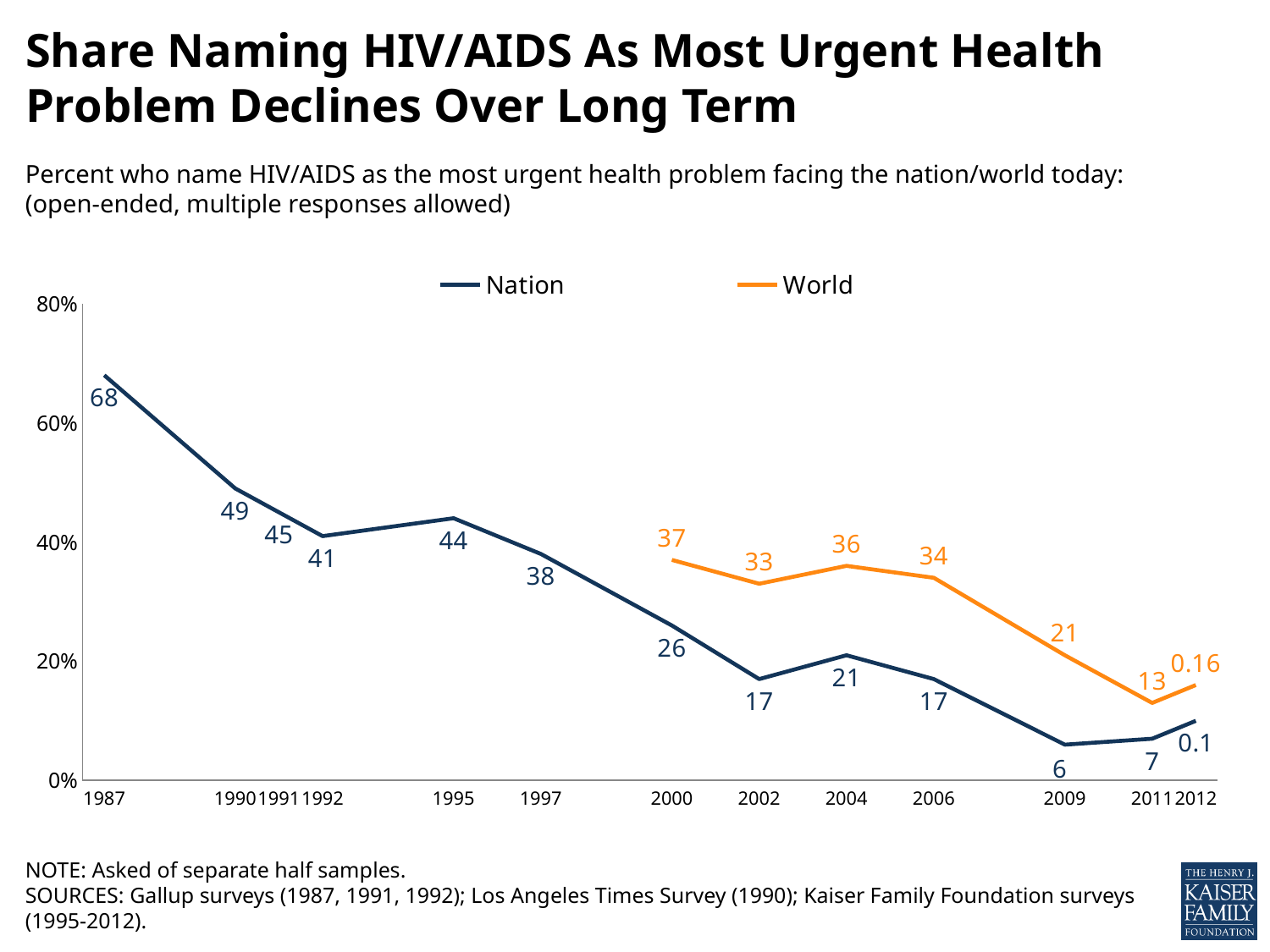
How many years are shown on the x axis? 13 How many series does the legend list? 2 In which year is the Nation series at its highest? 1987 What type of chart is shown on the slide? line chart What is the Nation value in 2009? 6 Which is larger in 2006, the Nation value or the World value? World Does the Nation series generally rise or fall from 1987 to 2009? fall What is the difference between the World and Nation values in 2002? 16 Which series is drawn in orange? World In which year is the Nation series at its lowest? 2009 What is the Nation value in 1987? 68 What is the World value in 2004? 36